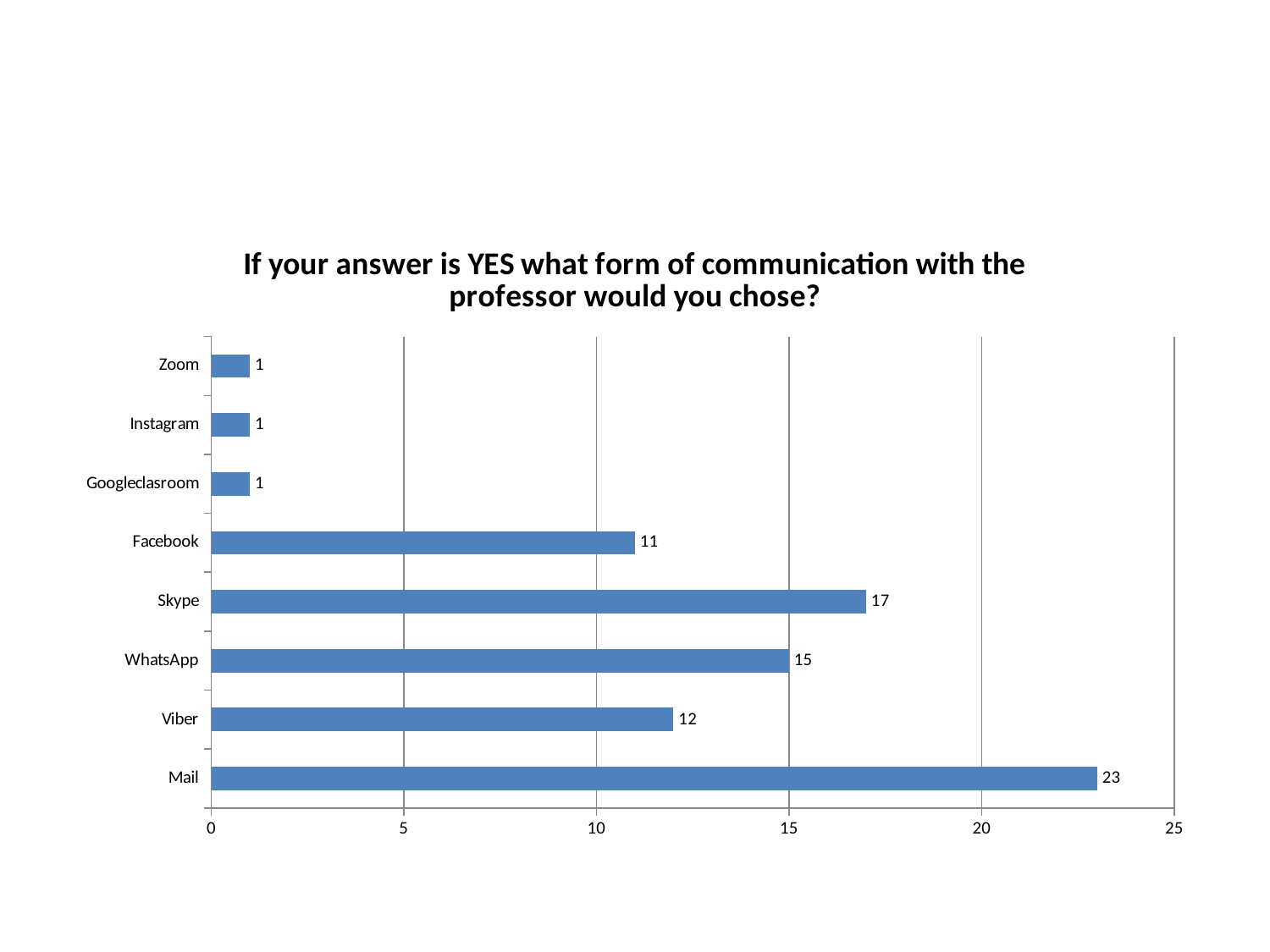
What is the value for Skype? 17 What is the title of the chart? If your answer is YES what form of communication with the professor would you chose? What kind of chart is shown on the slide? Bar chart What is the difference between the values for WhatsApp and Facebook? 4 What is the value for Viber? 12 How many categories are shown in the chart? 8 Which form of communication has the highest value? Mail Is the value for Facebook greater or less than 10? greater What is the value for Mail? 23 Which is larger, the value for WhatsApp or the value for Viber? WhatsApp How many categories have a value of 1? 3 What is the difference between the values for Mail and Skype? 6